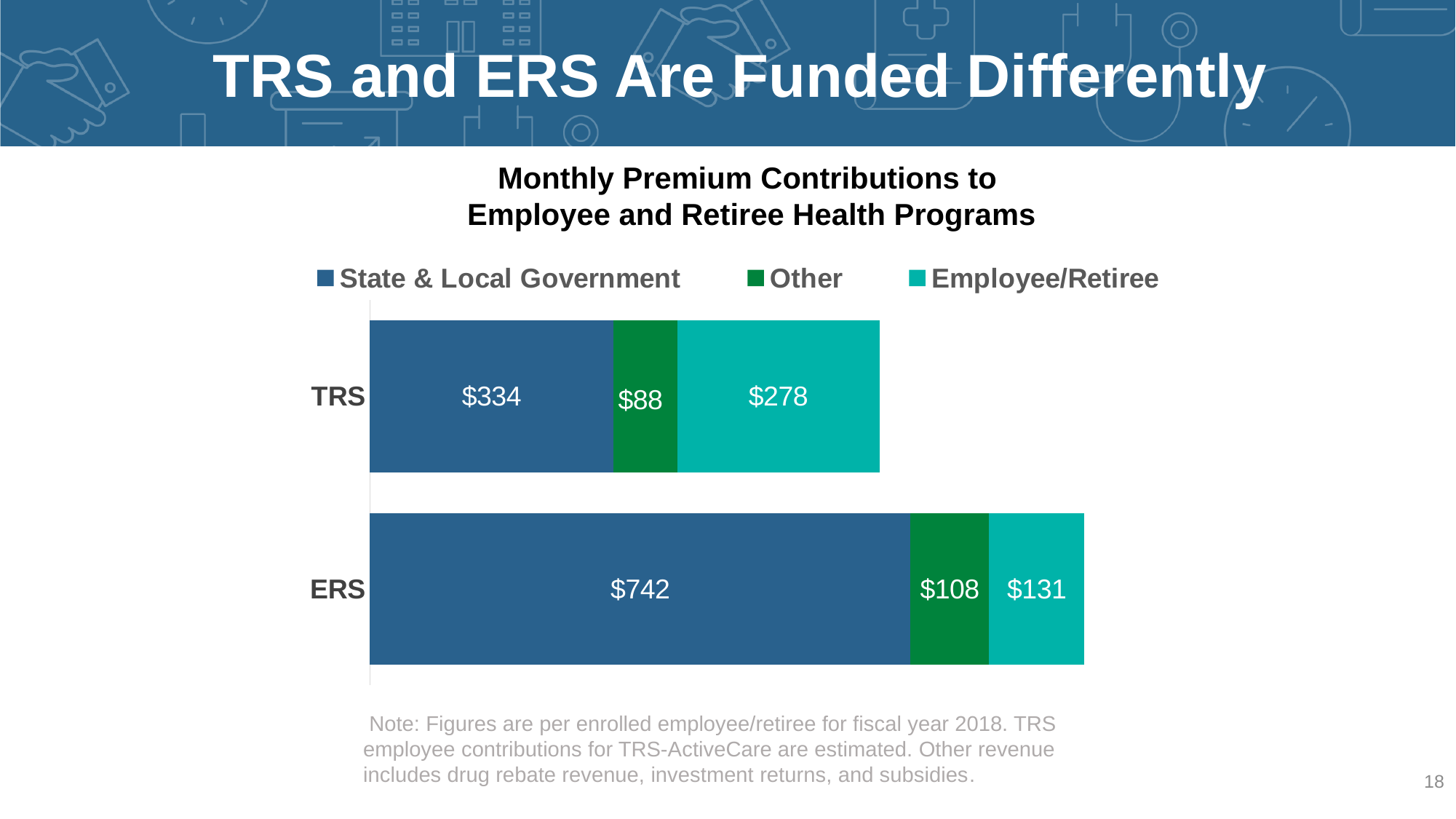
What is the Employee/Retiree contribution for ERS? $131 What is the total monthly premium contribution for ERS? $981 What type of chart is shown on the slide? Stacked bar chart How many series does the legend list? 3 What is the difference between the Other contributions for ERS and TRS? $20 What is the State & Local Government contribution for TRS? $334 What is the difference between the State & Local Government contributions for ERS and TRS? $408 Which program has the higher State & Local Government contribution, TRS or ERS? ERS What is the State & Local Government contribution for ERS? $742 Which program has the higher Employee/Retiree contribution, TRS or ERS? TRS What is the total monthly premium contribution for TRS? $700 What is the Other contribution for TRS? $88